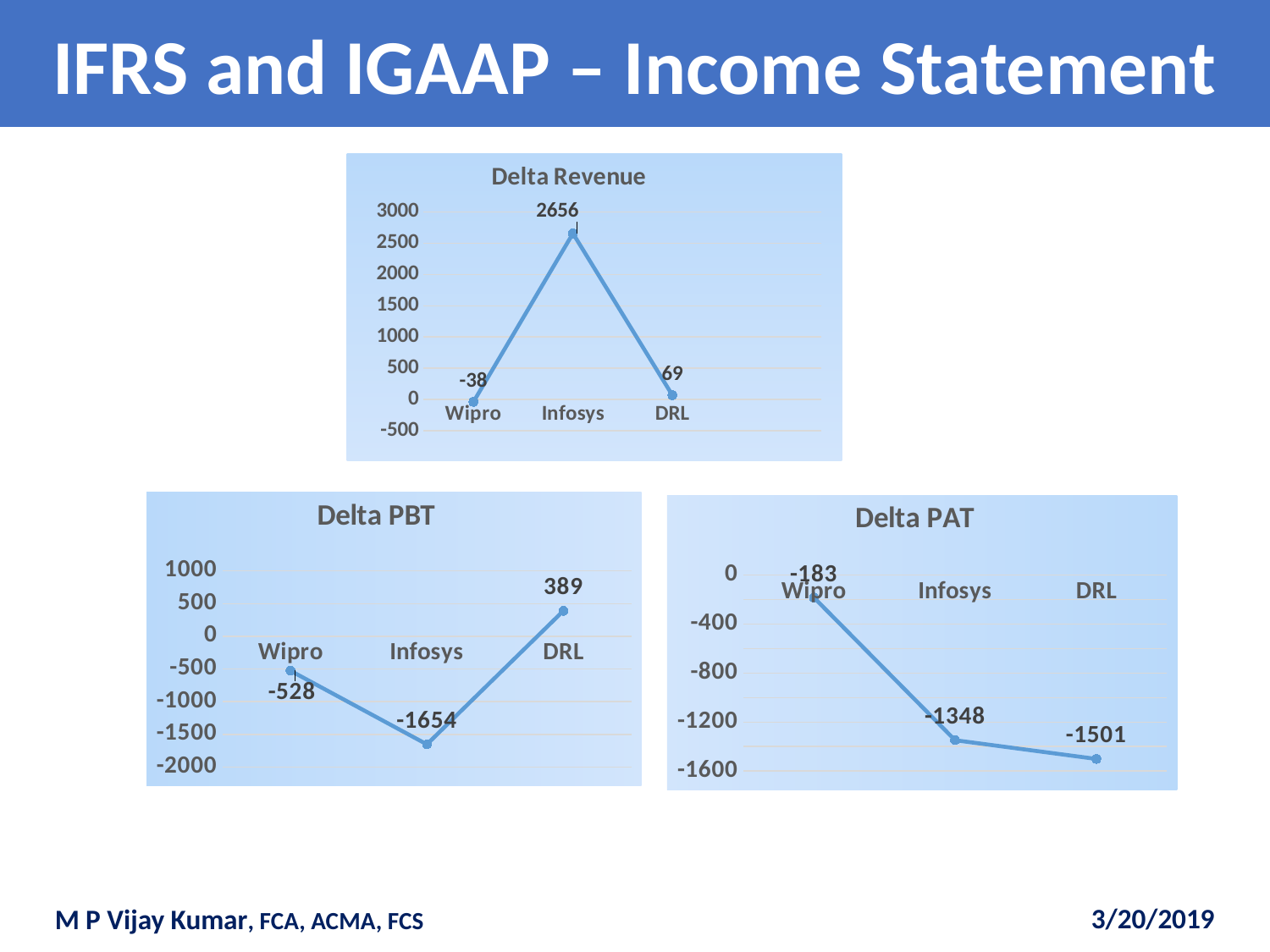
In the Delta Revenue chart, what is the value for Wipro? -38 In the Delta PBT chart, which is larger, the value for Wipro or the value for DRL? DRL In the Delta PBT chart, what is the value for Infosys? -1654 In the Delta Revenue chart, which company has the highest value? Infosys In the Delta PAT chart, do the values rise or fall from Wipro to DRL? fall In the Delta PAT chart, what is the value for DRL? -1501 In the Delta PBT chart, which company has the lowest value? Infosys What kind of chart is the Delta Revenue chart? line chart In the Delta Revenue chart, what is the difference between the values for Infosys and DRL? 2587 How many companies are plotted in the Delta PBT chart? 3 In the Delta PAT chart, what is the difference between the values for Wipro and Infosys? 1165 In the Delta Revenue chart, what is the value for Infosys? 2656